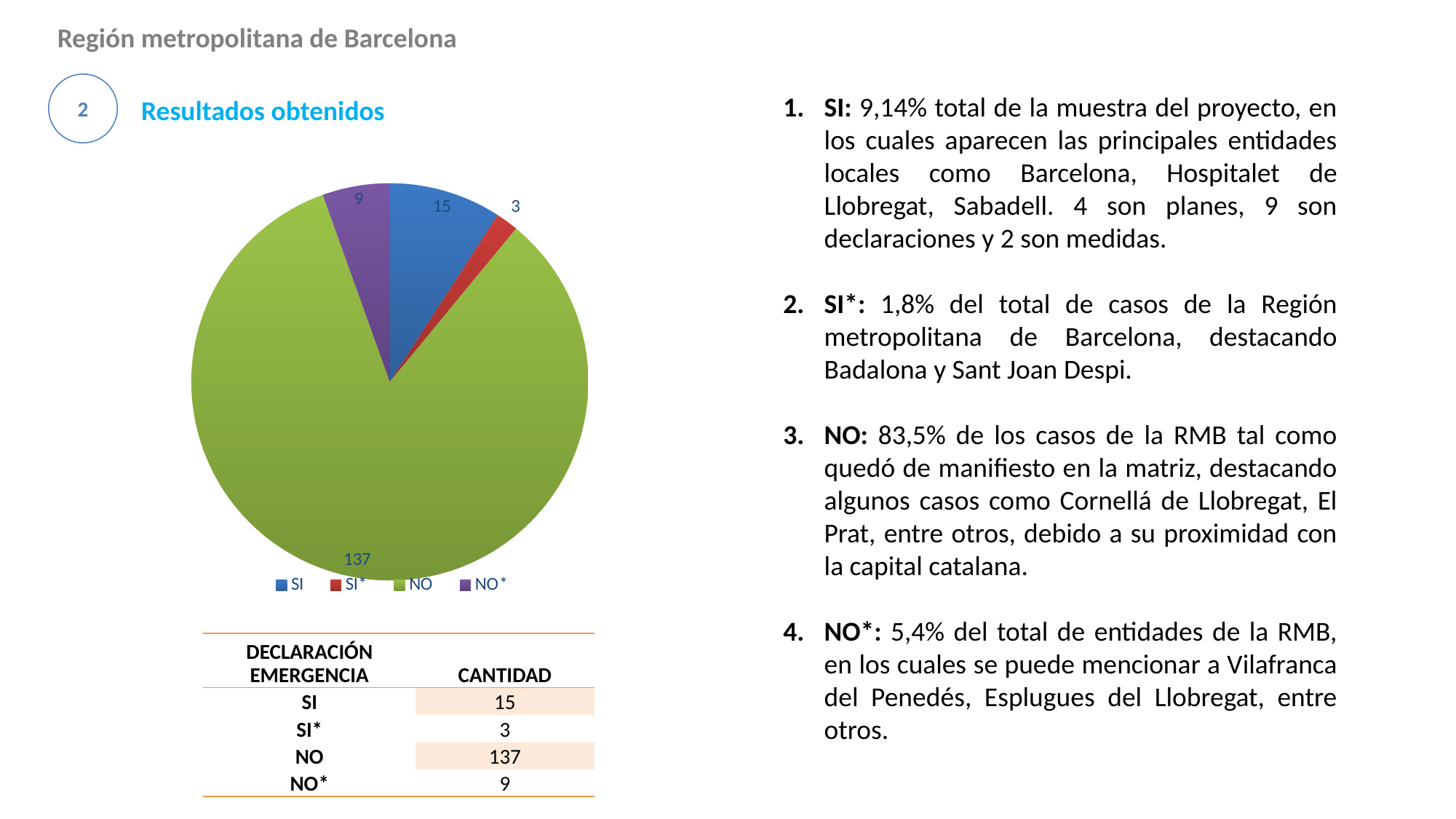
What is the total of all four values in the pie chart? 164 What colour is the NO slice in the pie chart? green What kind of chart is shown on the slide? pie chart Which category has the largest slice in the pie chart? NO How many slices does the pie chart have? 4 What is the value of the NO* slice in the pie chart? 9 What is the difference between the NO value and the SI value in the pie chart? 122 Which category has the smallest slice in the pie chart? SI* What is the value of the SI slice in the pie chart? 15 What is the value of the NO slice in the pie chart? 137 What is the value of the SI* slice in the pie chart? 3 Which is larger in the pie chart, SI or NO*? SI